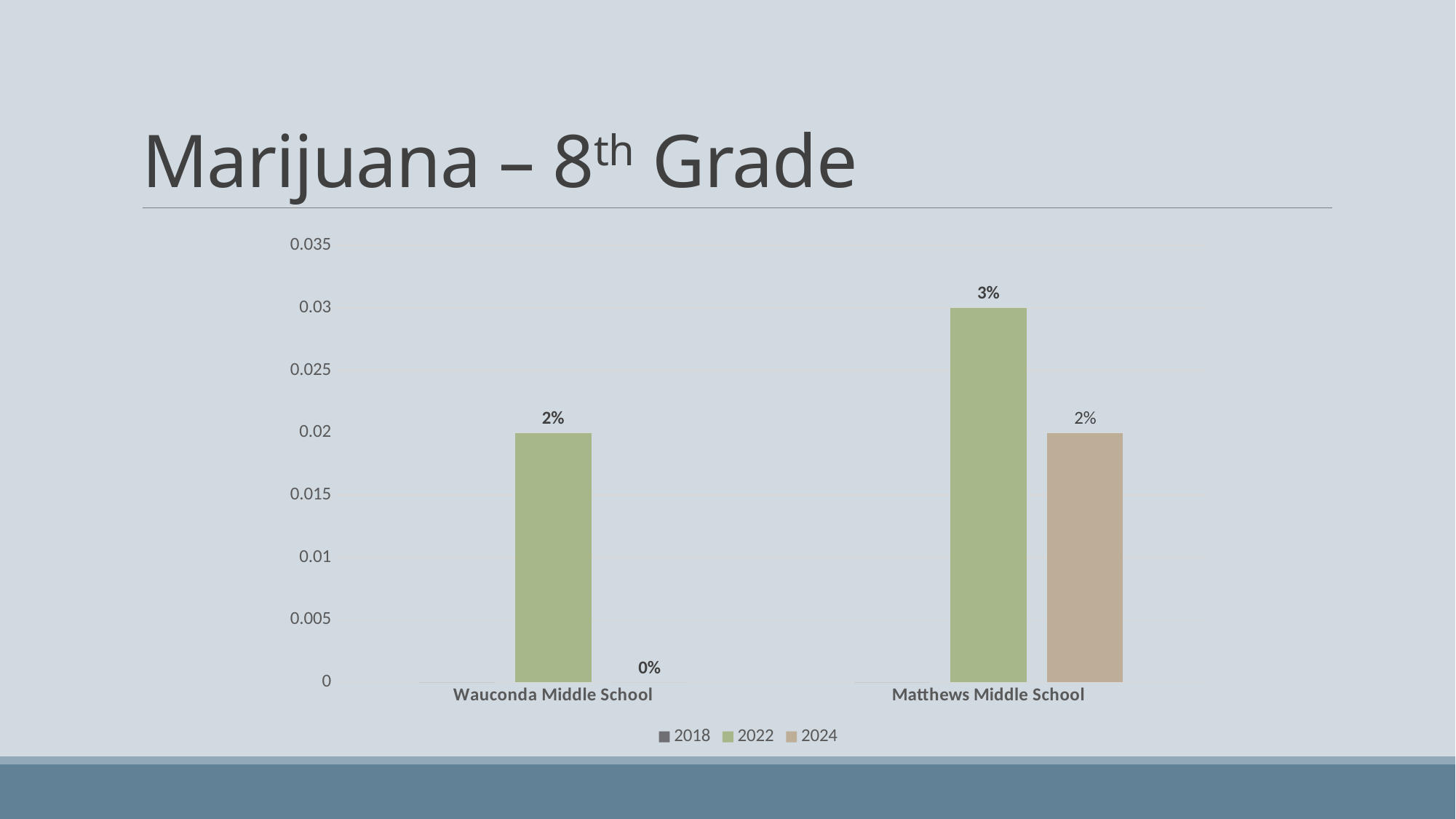
What kind of chart is shown on the slide? Bar chart What is the title of the slide? Marijuana – 8th Grade What is the 2024 value for Wauconda Middle School? 0% Which is larger for Matthews Middle School, the 2022 value or the 2024 value? 2022 Which school has the highest 2022 value? Matthews Middle School How many series does the legend list? 3 Which school has the lowest 2024 value? Wauconda Middle School What is the difference between the 2022 values for Matthews Middle School and Wauconda Middle School? 1% How many schools are shown on the x axis? 2 What is the 2022 value for Wauconda Middle School? 2% What is the 2024 value for Matthews Middle School? 2% What is the 2022 value for Matthews Middle School? 3%